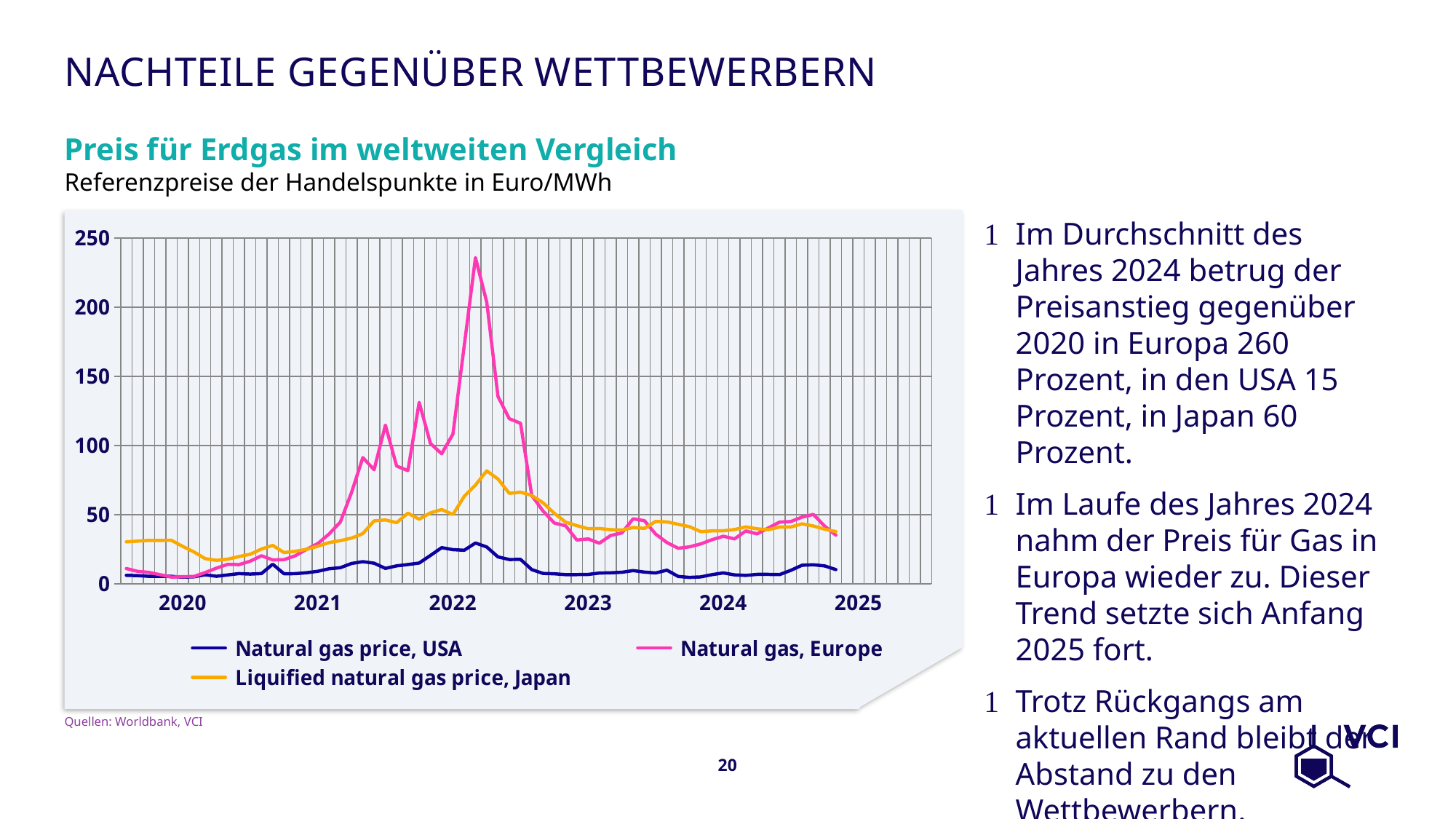
Is the peak value of the Liquified natural gas price, Japan series greater or less than 100? less Does the Natural gas, Europe series rise or fall between the start of 2021 and the start of 2022? rise Does the Natural gas, Europe series rise or fall between its 2022 peak and the start of 2023? fall What kind of chart is shown on the slide? line chart Is the highest value of the Natural gas price, USA series greater or less than 50? less What is the title of the chart? Preis für Erdgas im weltweiten Vergleich At the start of 2020, which is higher: the Liquified natural gas price, Japan or the Natural gas price, USA? Liquified natural gas price, Japan Which series is drawn in pink? Natural gas, Europe How many series does the chart legend list? 3 Is the peak value of the Natural gas, Europe series greater or less than 200? greater Which series reaches the highest value on the chart? Natural gas, Europe